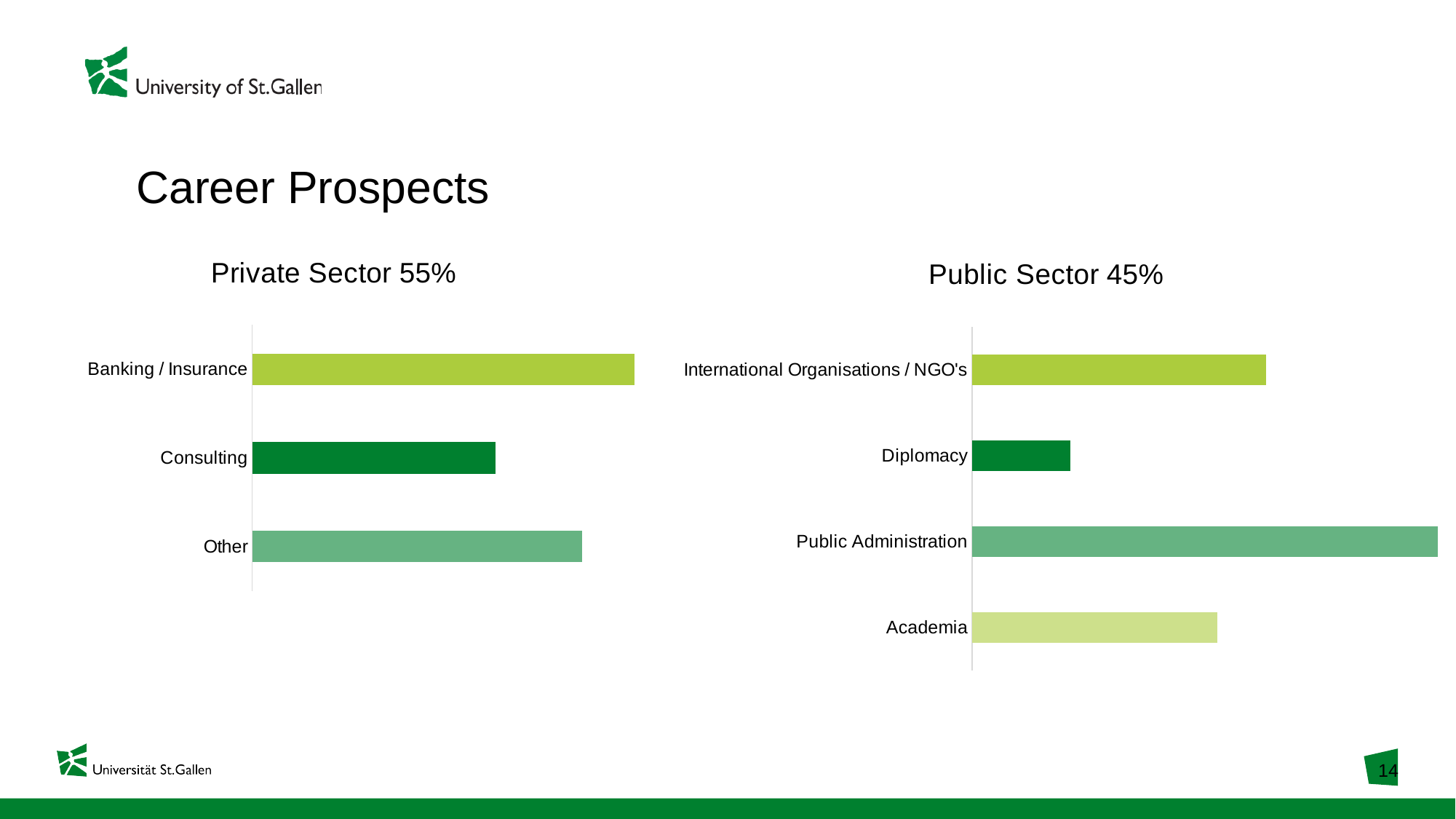
What is the title of the chart on the right side of the slide? Public Sector 45% In the Public Sector 45% chart, which is larger: Diplomacy or Academia? Academia In the Public Sector 45% chart, which is larger: International Organisations / NGO's or Academia? International Organisations / NGO's In the Private Sector 55% chart, which category has the longest bar? Banking / Insurance How many categories are shown in the Public Sector 45% chart? 4 In the Private Sector 55% chart, which category has the shortest bar? Consulting In the Public Sector 45% chart, which category has the longest bar? Public Administration What is the title of the chart on the left side of the slide? Private Sector 55% What type of chart is the Public Sector 45% chart? Bar chart How many categories are shown in the Private Sector 55% chart? 3 In the Public Sector 45% chart, which category has the shortest bar? Diplomacy In the Private Sector 55% chart, which is larger: Consulting or Other? Other